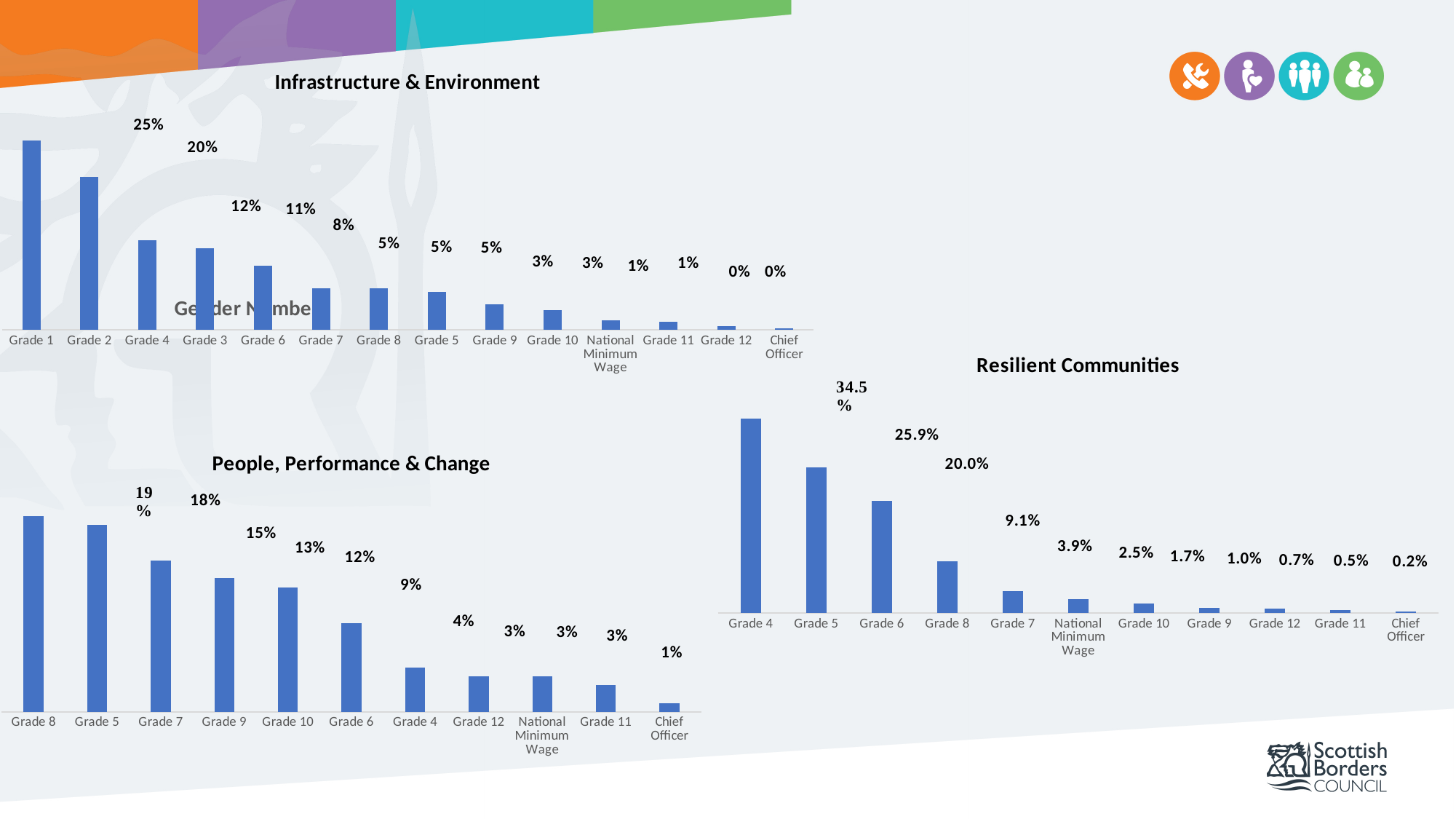
How many categories are shown in the People, Performance & Change chart? 11 In the People, Performance & Change chart, which category has the lowest value? Chief Officer In the People, Performance & Change chart, what is the value for Grade 7? 15% In the Infrastructure & Environment chart, what is the value for Grade 1? 25% In the Infrastructure & Environment chart, which category has the highest value? Grade 1 In the Resilient Communities chart, what is the value for Grade 8? 9.1% How many categories are shown in the Infrastructure & Environment chart? 14 In the People, Performance & Change chart, which is larger, Grade 10 or Grade 6? Grade 10 What type of chart is the Resilient Communities chart? Bar chart In the Infrastructure & Environment chart, what is the difference between Grade 2 and Grade 4? 8% In the Resilient Communities chart, which category has the highest value? Grade 4 In the Resilient Communities chart, what is the difference between Grade 4 and Grade 5? 8.6%